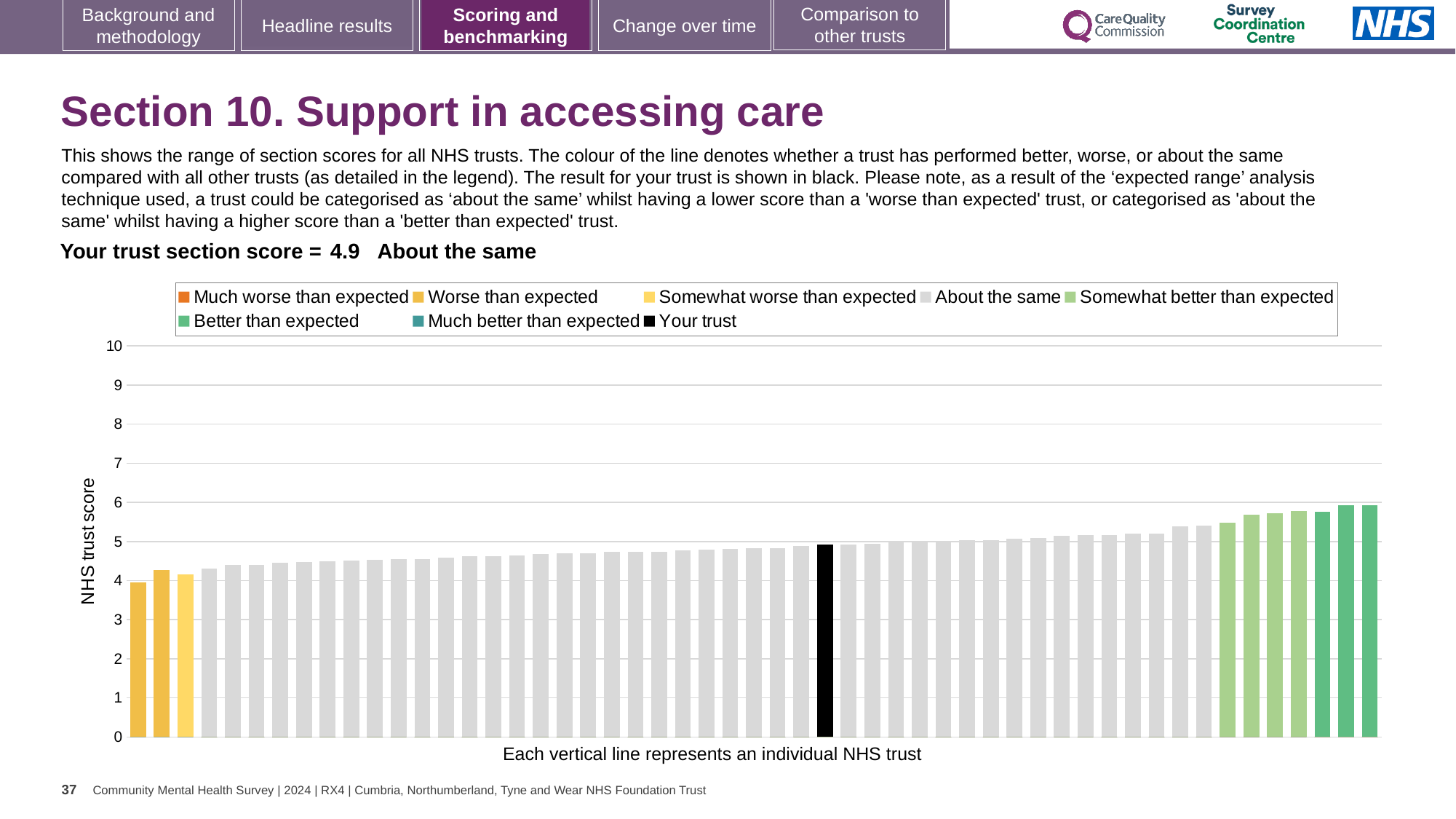
How many bars are coloured as 'Much better than expected'? 0 How many entries does the chart legend list? 8 Do the bar values rise or fall from left to right along the x axis? rise What colour is the bar representing your trust? black Is the value of the tallest bar greater or less than 5? greater Which performance category is your trust placed in for this section? About the same What is the section score for your trust shown on the slide? 4.9 What is the label on the vertical axis of the chart? NHS trust score What kind of chart is shown on the slide? bar chart How many bars are coloured as 'Worse than expected'? 2 Is the value of the black bar for your trust greater or less than 4? greater Is the value of the shortest bar greater or less than 3? greater